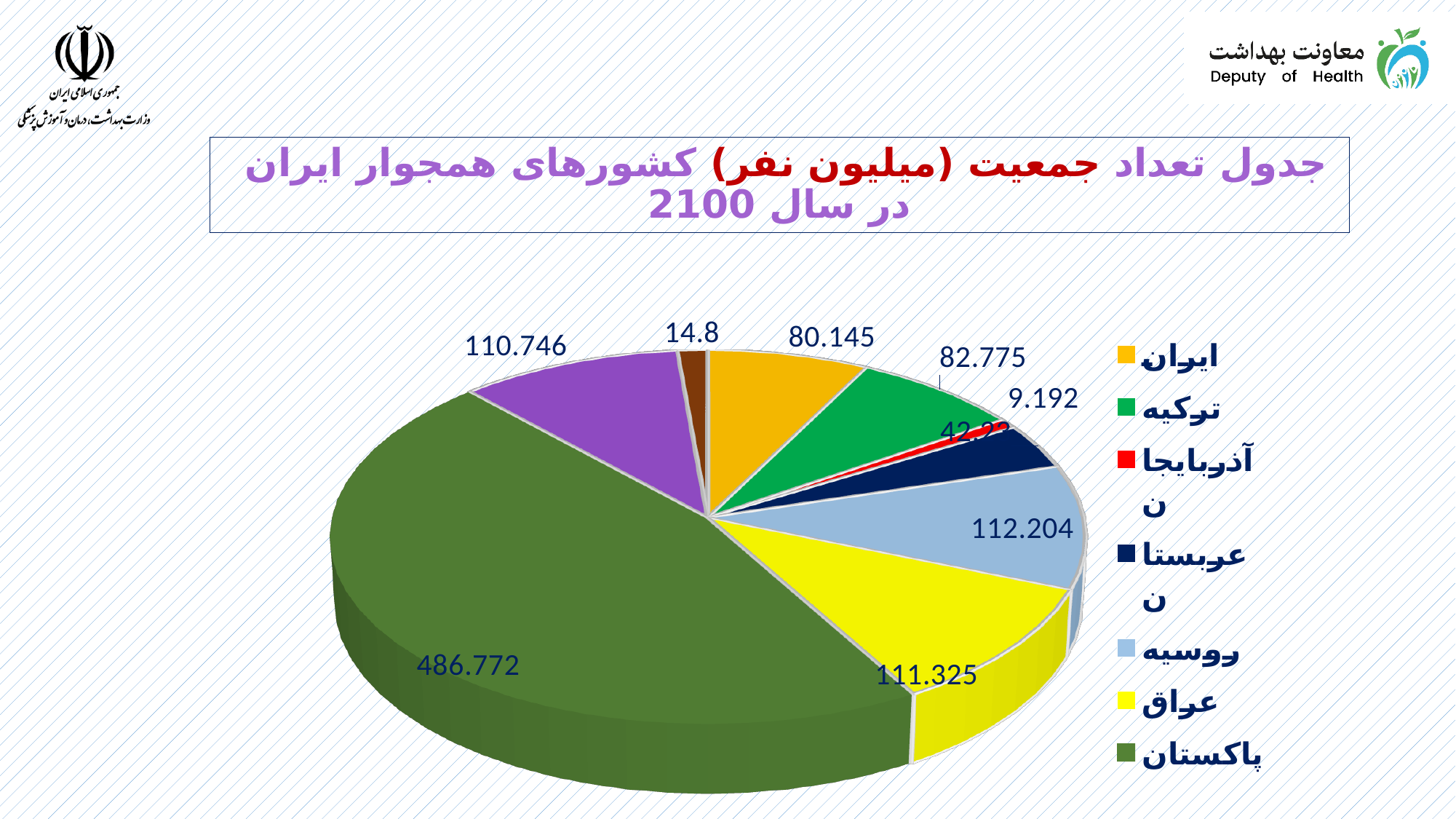
What is the value shown for ایران (Iran)? 80.145 What is the value shown for آذربایجان (Azerbaijan)? 9.192 What is the value shown for روسیه (Russia)? 112.204 What is the value shown for ترکیه (Turkey)? 82.775 Which country has the largest slice of the pie? پاکستان (Pakistan) Which legend country has the smallest value? آذربایجان (Azerbaijan) How many entries does the legend list? 7 What kind of chart is shown on the slide? pie chart Which is larger, the value for روسیه (Russia) or عراق (Iraq)? روسیه (Russia) What is the difference between the values for ترکیه (Turkey) and ایران (Iran)? 2.63 What is the value shown for عراق (Iraq)? 111.325 What is the value shown for پاکستان (Pakistan)? 486.772